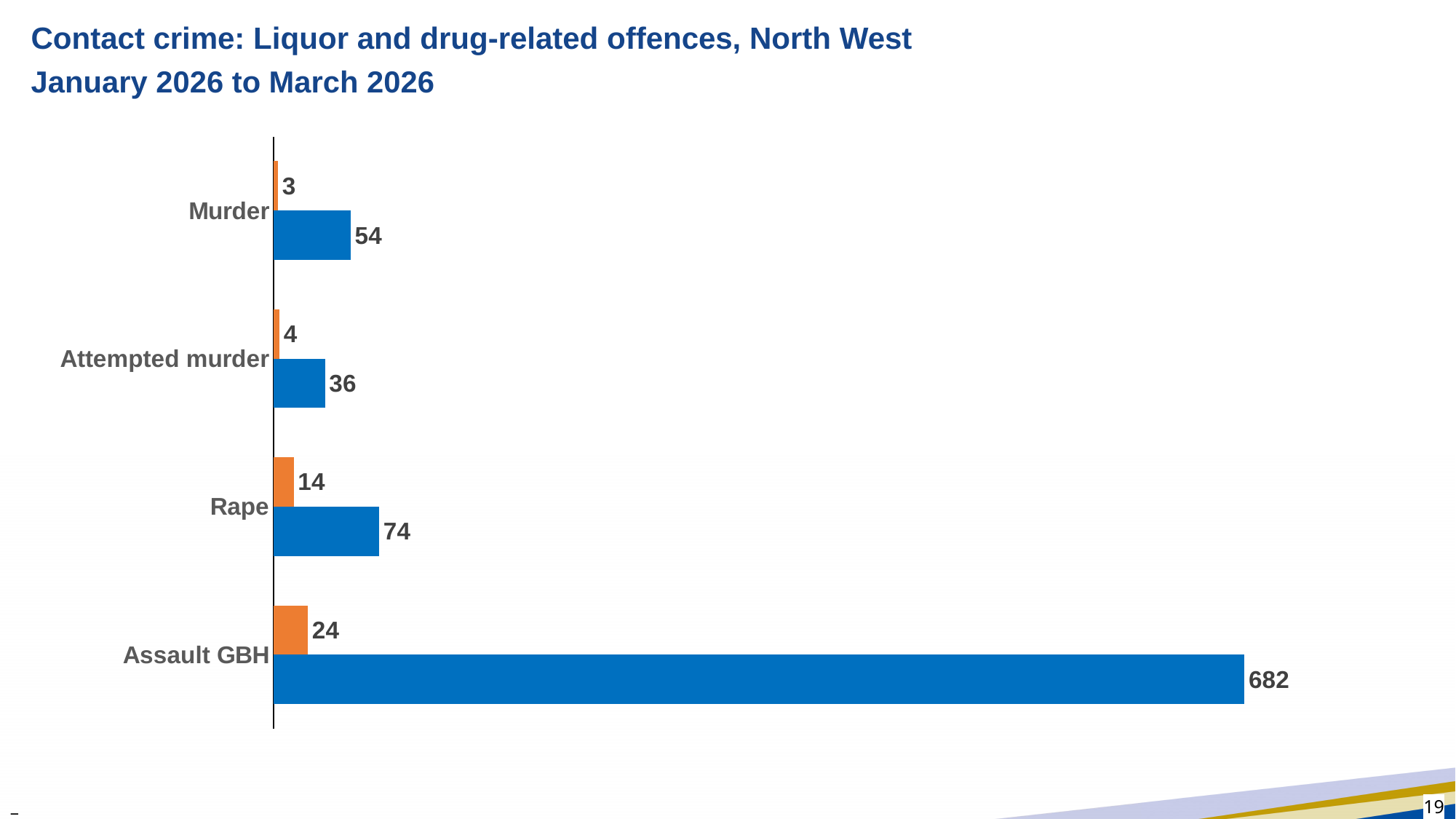
What is the value of the orange bar for Attempted murder? 4 Which category has the smallest blue bar? Attempted murder Which has a larger blue bar, Murder or Attempted murder? Murder Which category has the largest blue bar? Assault GBH What is the value of the orange bar for Rape? 14 What type of chart is shown on the slide? Bar chart What is the value of the blue bar for Murder? 54 For Assault GBH, how much larger is the blue bar than the orange bar? 658 What is the difference between the blue bar for Rape and the blue bar for Attempted murder? 38 What is the value of the blue bar for Assault GBH? 682 How many crime categories are shown on the chart? 4 Which category has the smallest orange bar? Murder